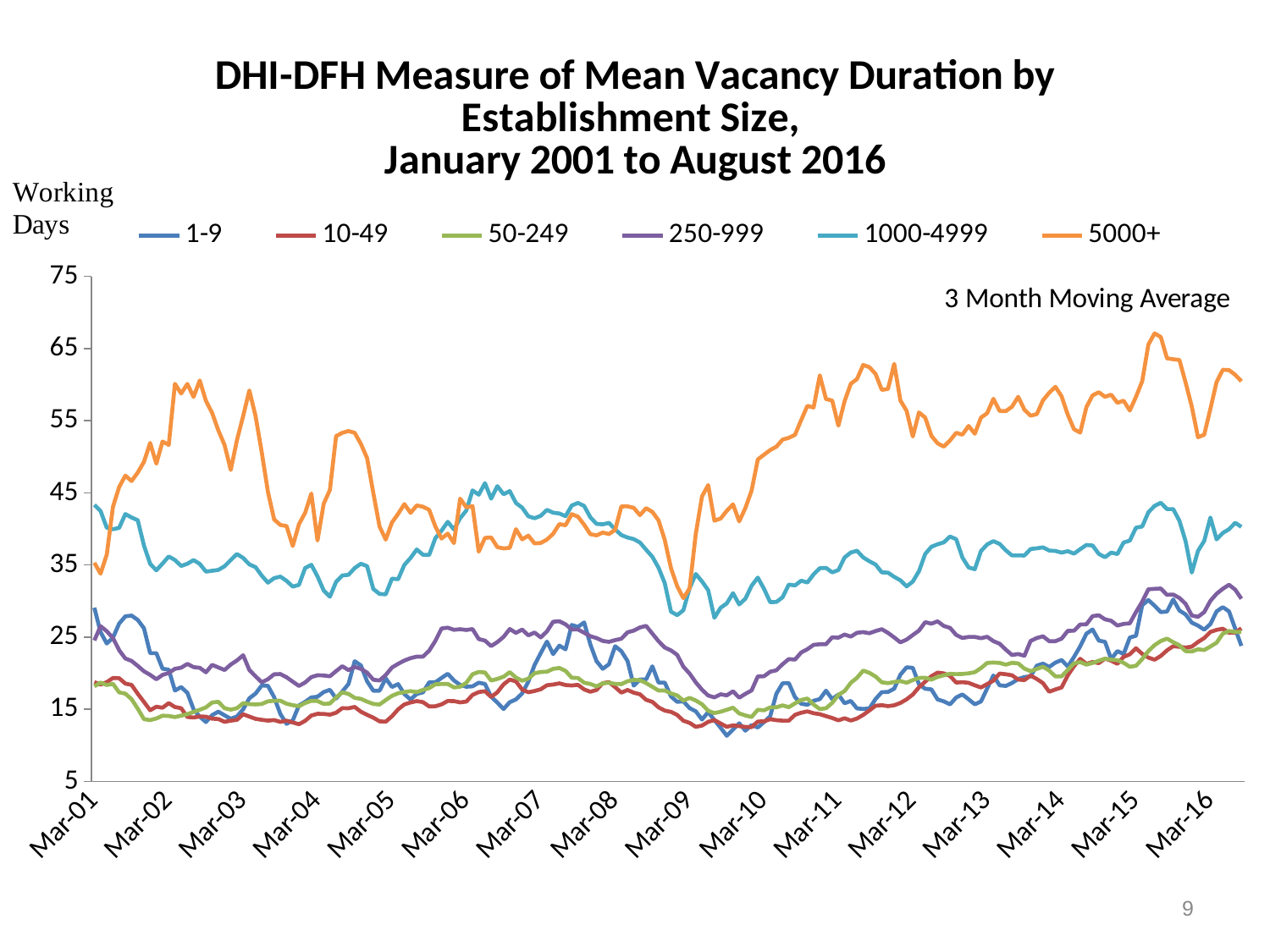
Does the 5000+ series rise or fall between Mar-09 and Mar-11? rise Is the value for the 10-49 series at Mar-02 greater or less than 25? less What unit is shown on the vertical axis label? Working Days How many series does the legend list? 6 What kind of chart is shown on the slide? line chart Which series has the highest values at Mar-16? 5000+ Is the value for the 5000+ series at Mar-16 greater or less than 45? greater Is the value for the 1000-4999 series at Mar-09 greater or less than 35? less What are the establishment size categories listed in the legend? 1-9, 10-49, 50-249, 250-999, 1000-4999, 5000+ At Mar-16, which series is larger: 1000-4999 or 250-999? 1000-4999 How many year labels are shown on the x axis? 16